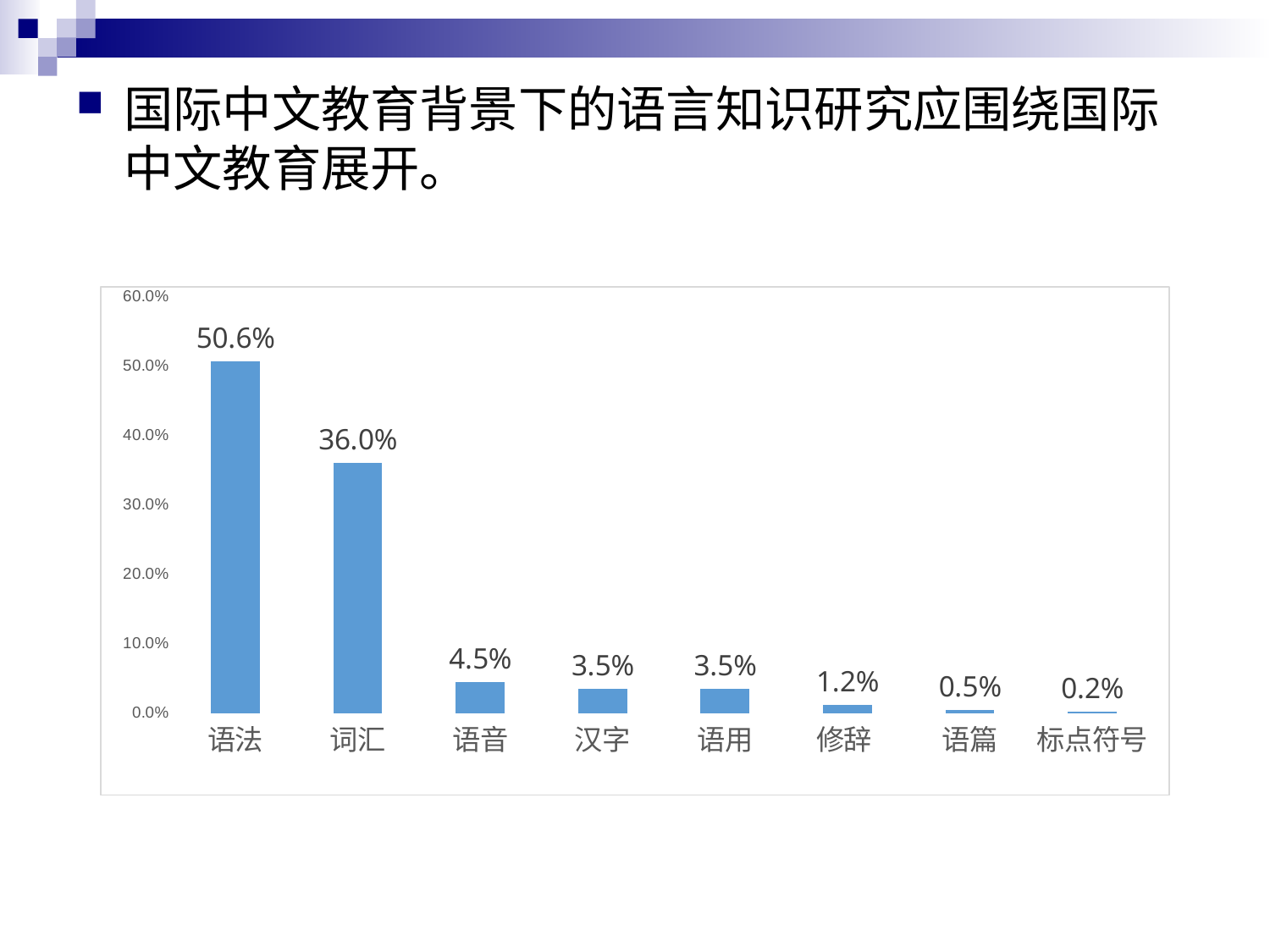
What is the value for 语法? 50.6% Which category has the highest value? 语法 What is the difference between the values for 语法 and 词汇? 14.6% Which category has the lowest value? 标点符号 What is the value for 标点符号? 0.2% Is the value for 词汇 greater or less than 40.0%? less Which is larger, the value for 语音 or the value for 修辞? 语音 What kind of chart is shown on the slide? bar chart What is the value for 词汇? 36.0% What is the value for 语音? 4.5% Do the values rise or fall from left to right along the x axis? fall How many categories are shown on the x axis? 8